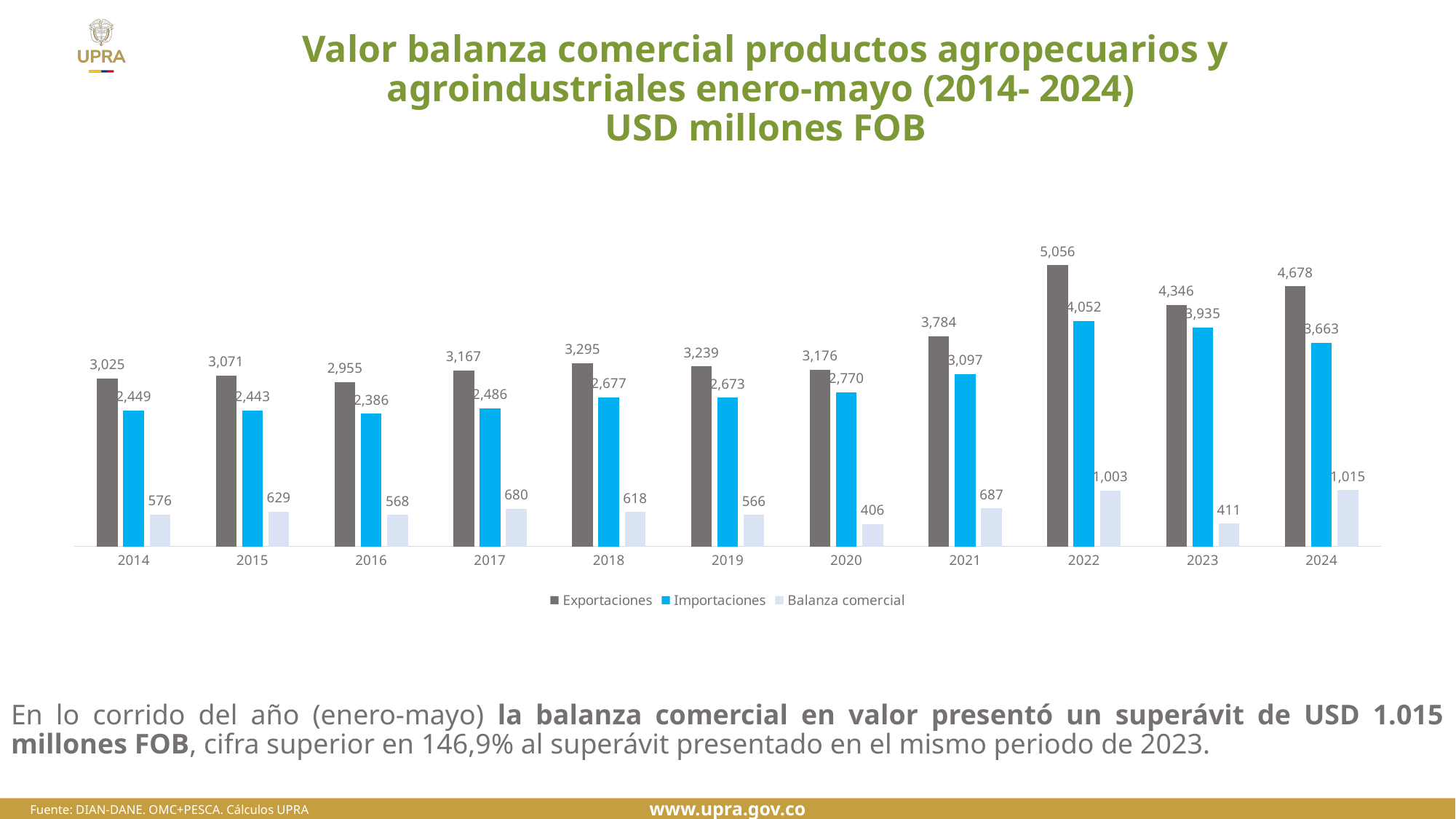
Do the Importaciones values rise or fall from 2020 to 2022? Rise Which is larger, Importaciones in 2021 or Importaciones in 2019? Importaciones in 2021 What is the difference between Exportaciones and Importaciones in 2024? 1,015 In which year is Balanza comercial lowest? 2020 How many years are shown on the x axis? 11 What is the value of Exportaciones for 2022? 5,056 What is the value of Balanza comercial for 2020? 406 What kind of chart is shown on the slide? Bar chart How many series does the legend list? 3 What is the value of Importaciones for 2016? 2,386 In which year is Exportaciones highest? 2022 What colour are the Importaciones bars? Blue